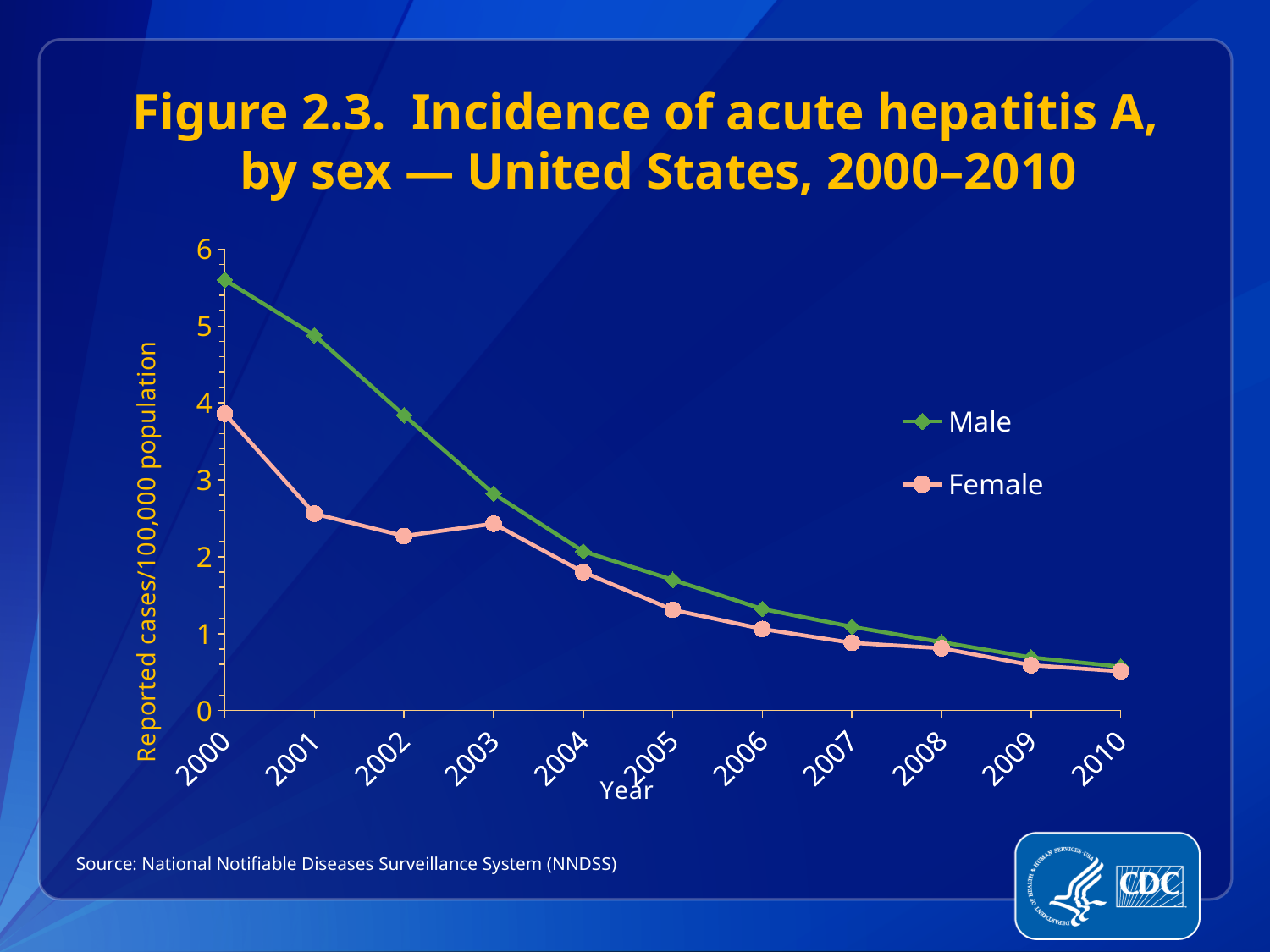
How many years are plotted along the x axis? 11 What is the label of the y axis? Reported cases/100,000 population Which series has the larger value in 2002, Male or Female? Male How many series does the legend list? 2 In which year is the Male incidence lowest? 2010 Is the Male value for 2000 greater or less than 5? greater Do the Male values rise or fall from 2000 to 2010? fall What kind of chart is shown on the slide? line chart Is the Female value for 2004 greater or less than 2? less In which year is the Male incidence highest? 2000 Is the Male value for 2003 greater or less than 3? less In which year is the Female incidence highest? 2000